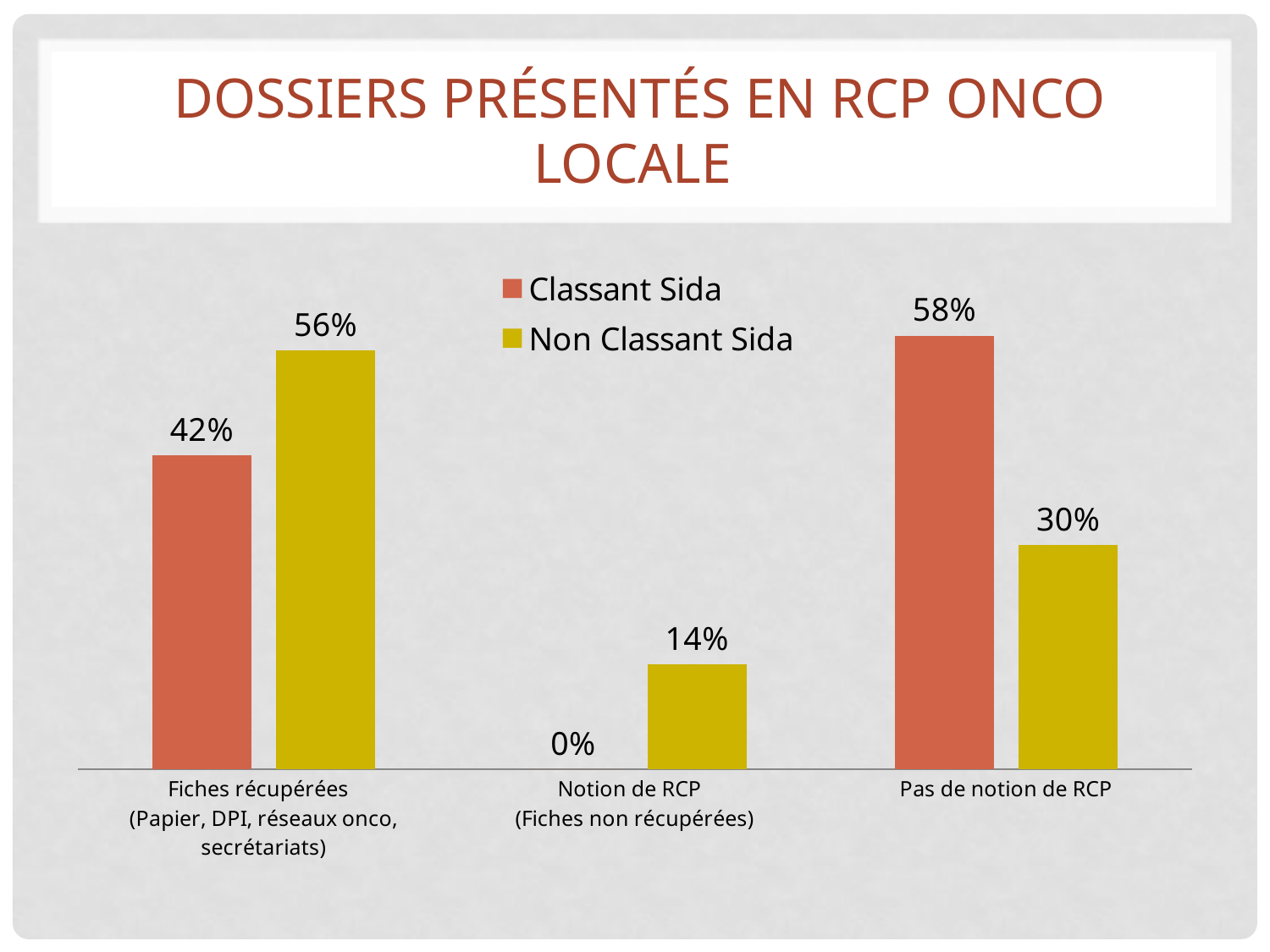
In the Pas de notion de RCP category, which series has the larger value, Classant Sida or Non Classant Sida? Classant Sida What is the value for Classant Sida in the Pas de notion de RCP category? 58% What is the value for Classant Sida in the Fiches récupérées category? 42% What is the difference between Non Classant Sida and Classant Sida in the Fiches récupérées category? 14% What is the value for Non Classant Sida in the Notion de RCP category? 14% Which category has the lowest value for the Classant Sida series? Notion de RCP How many series does the legend list? 2 What kind of chart is shown on the slide? Bar chart What is the value for Non Classant Sida in the Pas de notion de RCP category? 30% How many categories are shown on the x axis? 3 Which category has the highest value for the Non Classant Sida series? Fiches récupérées What is the difference between Classant Sida and Non Classant Sida in the Pas de notion de RCP category? 28%